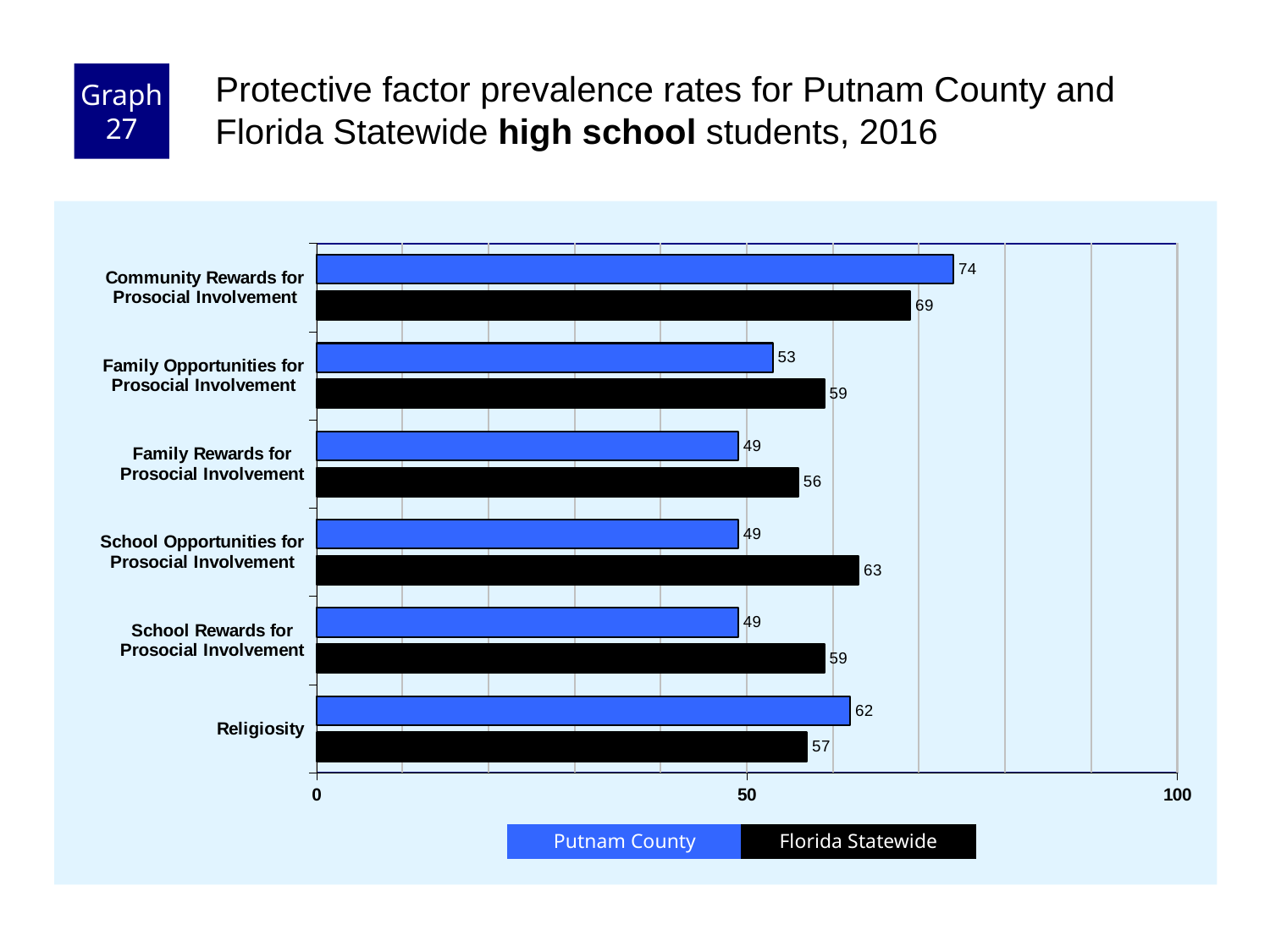
Which colour represents Florida Statewide in the chart? black For Religiosity, which is larger: the Putnam County value or the Florida Statewide value? Putnam County Is the Putnam County value for Family Opportunities for Prosocial Involvement greater or less than 50? greater What is the Putnam County value for Community Rewards for Prosocial Involvement? 74 What is the difference between the Florida Statewide and Putnam County values for School Opportunities for Prosocial Involvement? 14 What is the Florida Statewide value for School Opportunities for Prosocial Involvement? 63 Which category has the highest Putnam County value? Community Rewards for Prosocial Involvement What is the Florida Statewide value for Religiosity? 57 Which category has the lowest Florida Statewide value? Family Rewards for Prosocial Involvement What kind of chart is shown on the slide? bar chart How many categories are shown on the chart? 6 How many series does the legend list? 2